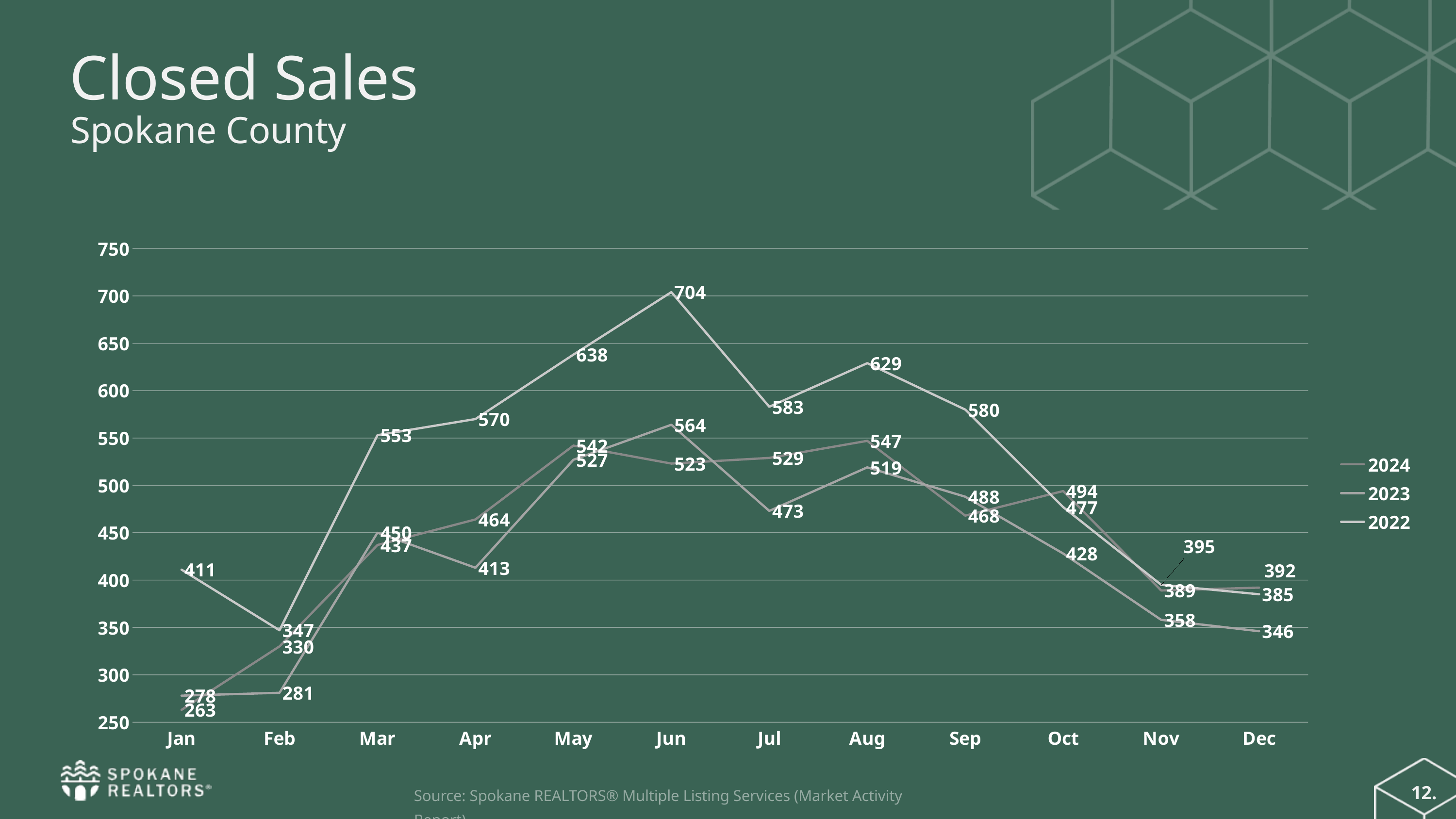
What is the highest value shown for Jan? 411 What is the highest value plotted anywhere on the chart? 704 In which month does the chart reach its highest plotted value? Jun Is the highest value shown for Jun greater or less than 700? greater What is the lowest value plotted anywhere on the chart? 263 How many months are shown along the x axis? 12 What is the lowest value shown for Dec? 346 What are the entries listed in the legend? 2024, 2023, 2022 What is the difference between the highest and lowest values shown for Jun? 181 How many series does the legend list? 3 What kind of chart is shown on the slide? line chart Do the values of the top line rise or fall from Jun to Dec? fall